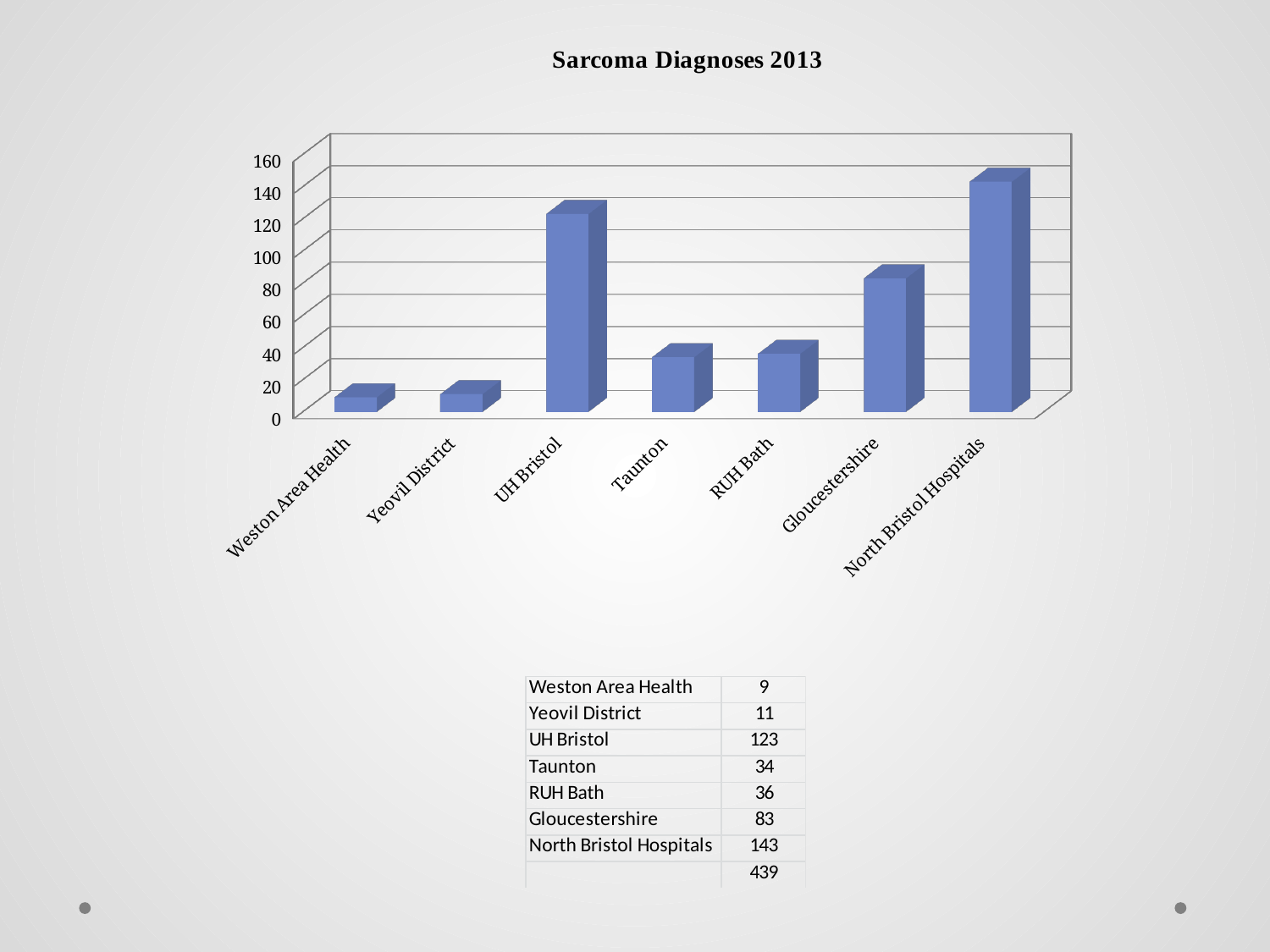
What kind of chart is shown on the slide? bar chart Which category has the highest number of sarcoma diagnoses? North Bristol Hospitals What is the total of all the values shown in the table? 439 How many hospitals/categories are plotted in the chart? 7 What is the difference between North Bristol Hospitals and UH Bristol? 20 Which category has the lowest number of sarcoma diagnoses? Weston Area Health Is the value for Taunton greater or less than 40? less What is the title of the chart? Sarcoma Diagnoses 2013 What is the value for Yeovil District? 11 Which is larger, the value for Gloucestershire or the value for RUH Bath? Gloucestershire What is the value for UH Bristol? 123 What is the value for Gloucestershire? 83